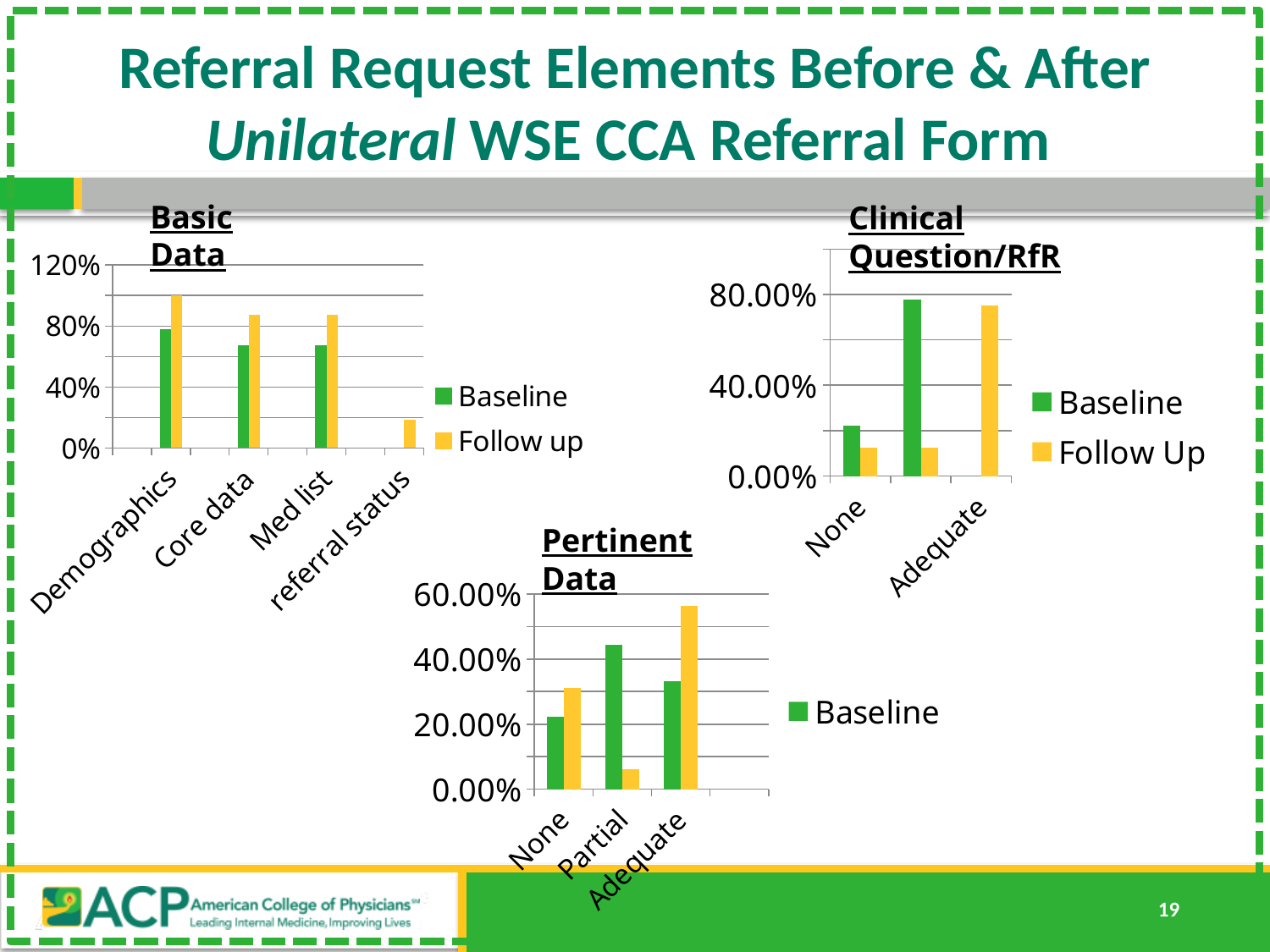
On the Basic Data chart, how many categories are shown on the x axis? 4 On the Basic Data chart, is the Follow up value for referral status greater or less than 40%? less On the Basic Data chart, how many series does the legend list? 2 On the Basic Data chart, which is larger for Core data, Baseline or Follow up? Follow up On the Basic Data chart, what kind of chart is shown? bar chart On the Pertinent Data chart, is the Baseline value for None greater or less than 40.00%? less On the Pertinent Data chart, which category has the highest Baseline value? Partial On the Basic Data chart, is the Follow up value for Demographics greater or less than 80%? greater On the Basic Data chart, which category has the highest Follow up value? Demographics